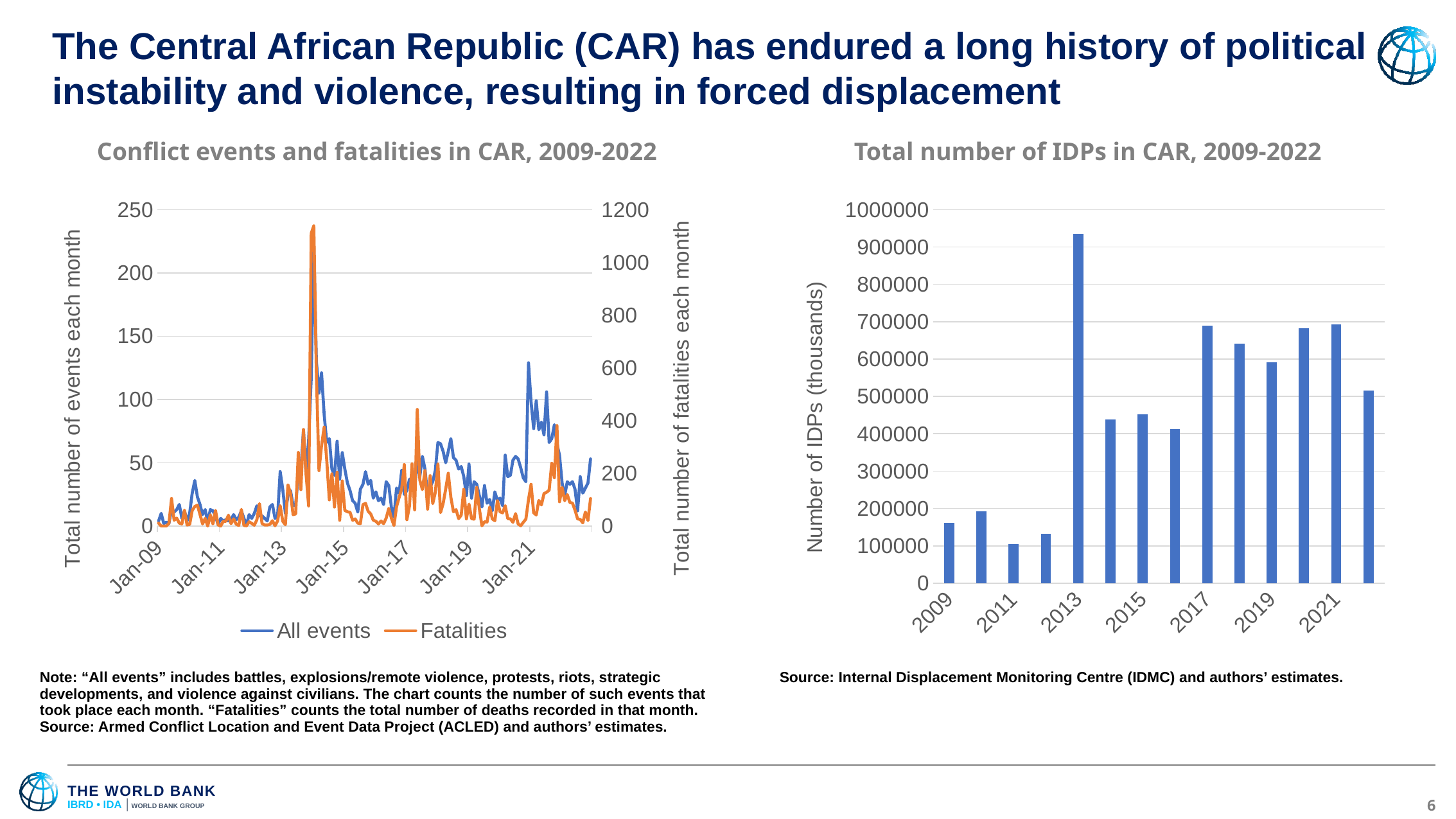
In the 'Total number of IDPs in CAR, 2009-2022' chart, which year has the highest number of IDPs? 2013 In the 'Total number of IDPs in CAR, 2009-2022' chart, which year has more IDPs, 2017 or 2018? 2017 What kind of chart is the 'Total number of IDPs in CAR, 2009-2022' chart? bar chart In the 'Total number of IDPs in CAR, 2009-2022' chart, which year has the lowest number of IDPs? 2011 How many series does the legend of the 'Conflict events and fatalities in CAR, 2009-2022' chart list? 2 In the 'Total number of IDPs in CAR, 2009-2022' chart, is the value for 2016 greater or less than 500000? less In the 'Total number of IDPs in CAR, 2009-2022' chart, how many bars are plotted? 14 In the 'Total number of IDPs in CAR, 2009-2022' chart, which year has more IDPs, 2013 or 2014? 2013 In the 'Total number of IDPs in CAR, 2009-2022' chart, is the value for 2013 greater or less than 900000? greater What kind of chart is the 'Conflict events and fatalities in CAR, 2009-2022' chart? line chart What are the two legend entries in the 'Conflict events and fatalities in CAR, 2009-2022' chart? All events and Fatalities In the 'Conflict events and fatalities in CAR, 2009-2022' chart, is the peak value of the Fatalities series greater or less than 1000? greater